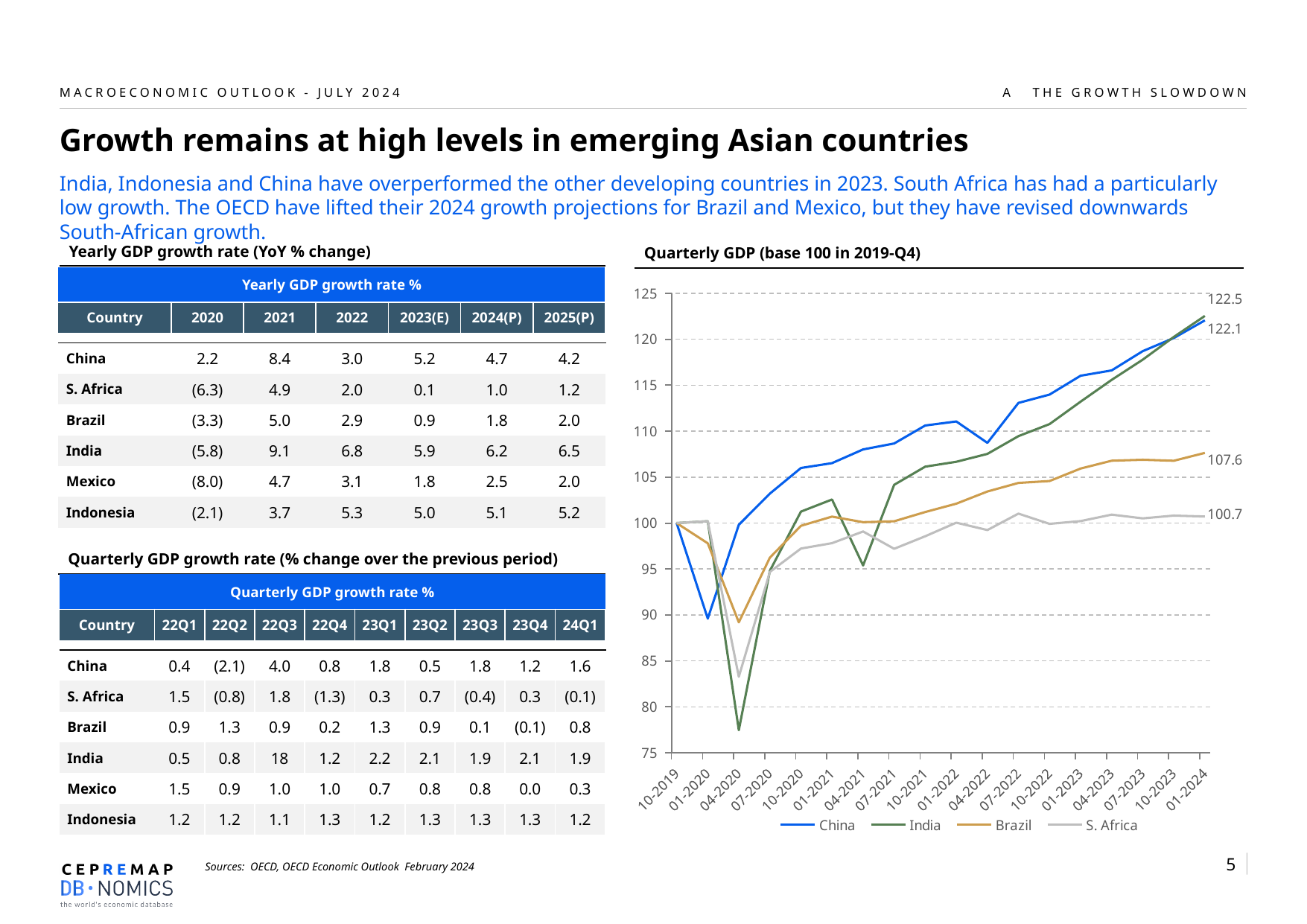
In the Quarterly GDP chart, what is the value labelled at the end of the S. Africa line? 100.7 In the Quarterly GDP chart, is the value for China at 04-2020 greater or less than 95? greater In the Quarterly GDP chart, does the S. Africa line rise or fall overall from 04-2020 to 01-2024? rise In the Quarterly GDP chart, what is the difference between the final labelled values for Brazil (107.6) and S. Africa (100.7)? 6.9 In the Quarterly GDP chart, at 01-2024 which is larger, Brazil or S. Africa? Brazil How many series does the legend of the Quarterly GDP chart list? 4 What kind of chart is the Quarterly GDP chart? line chart In the Quarterly GDP chart, which series has the highest value at 04-2021? China In the Quarterly GDP chart, what is the value labelled at the end of the Brazil line? 107.6 In the Quarterly GDP chart, which series has the lowest value at 04-2020? India In the Quarterly GDP chart, is the value for India at 04-2020 greater or less than 80? less What base period is used for the index in the Quarterly GDP chart, according to its title? 2019-Q4